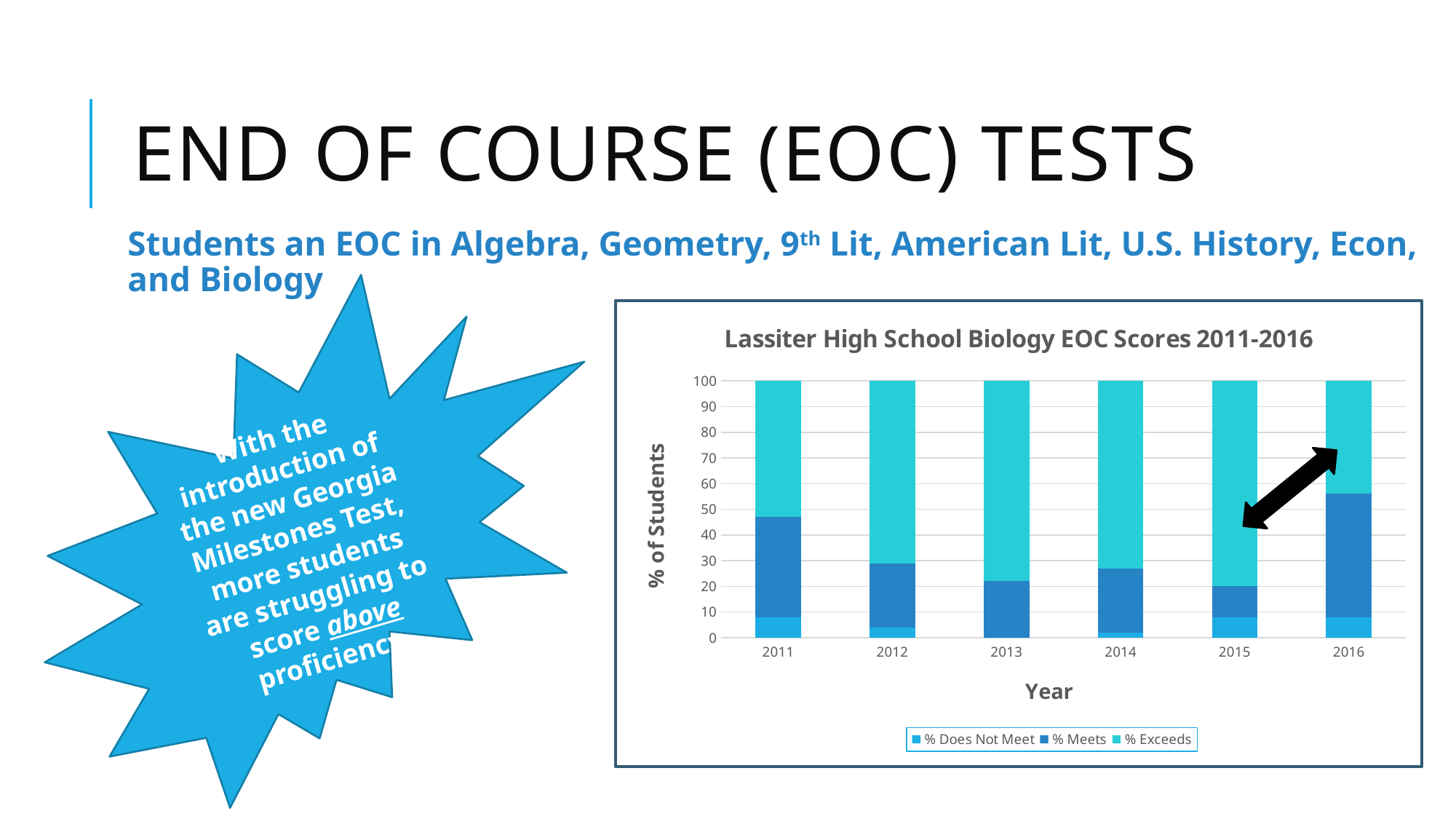
What is the total height of the stacked bar for 2011? 100 Is the % Meets segment larger in 2011 or in 2012? 2011 Is the top of the % Meets segment in 2015 greater or less than 30? less How many years are shown on the x axis of the chart? 6 Which year has the largest % Exceeds segment? 2015 Is the % Exceeds segment larger in 2015 or in 2016? 2015 Which year has the smallest % Exceeds segment? 2016 What kind of chart is shown on the slide? stacked bar chart What is the title of the chart? Lassiter High School Biology EOC Scores 2011-2016 What are the three series listed in the chart legend? % Does Not Meet, % Meets, % Exceeds Is the top of the % Meets segment in 2016 greater or less than 50? greater How many series does the chart legend list? 3